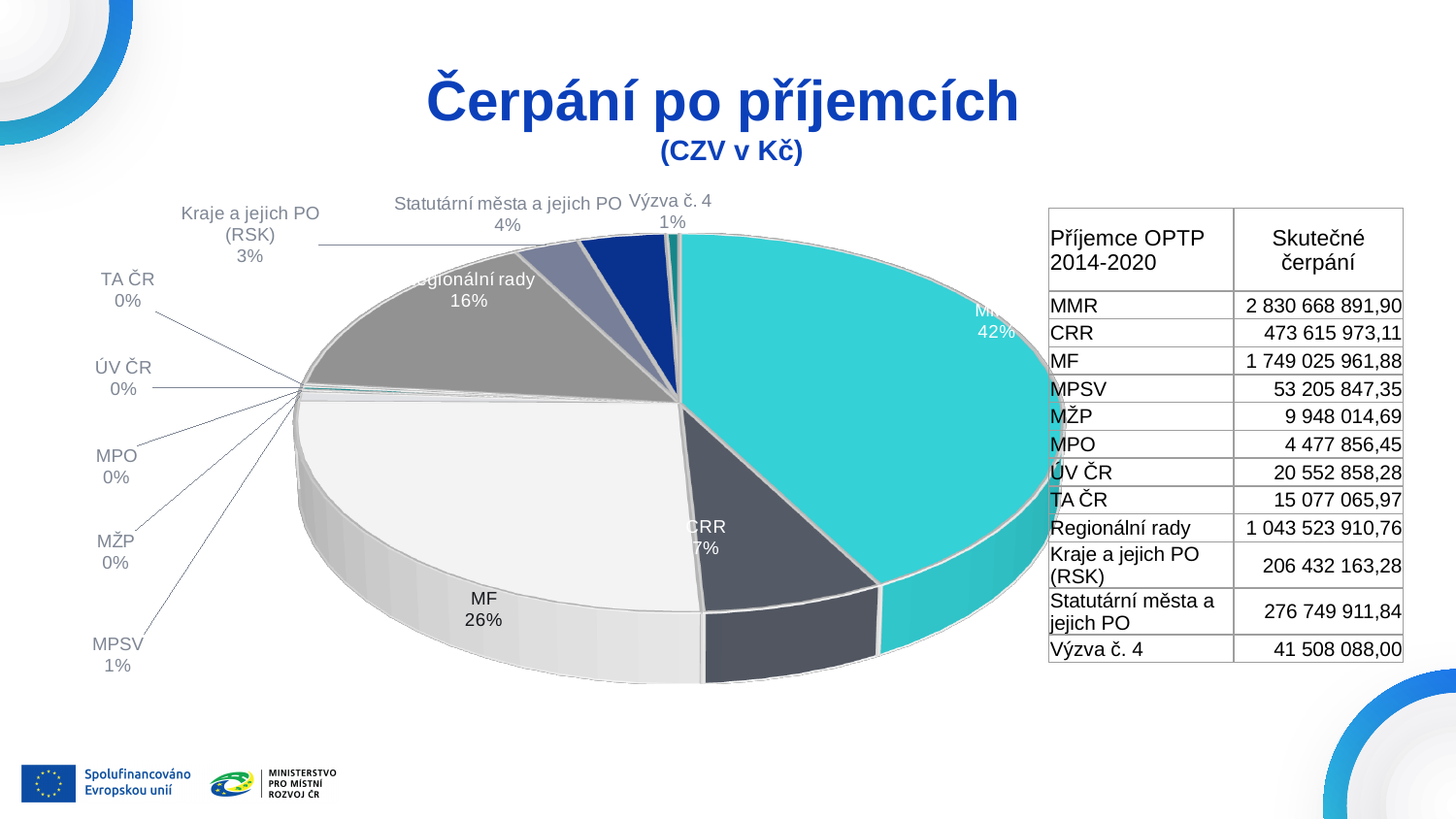
What percentage is shown for Kraje a jejich PO (RSK)? 3% How many categories are labelled on the pie chart? 12 What percentage is shown for Výzva č. 4? 1% What is the difference in percentage points between the MF slice and the Regionální rady slice? 10% What share of the pie does MF account for? 26% What kind of chart is shown on the slide? pie chart What percentage is shown for Statutární města a jejich PO? 4% What percentage is shown for MPSV? 1% Which category has the largest slice of the pie? MMR What is the title of the slide above the chart? Čerpání po příjemcích Which slice is larger, MF or Regionální rady? MF What share of the pie does Regionální rady account for? 16%